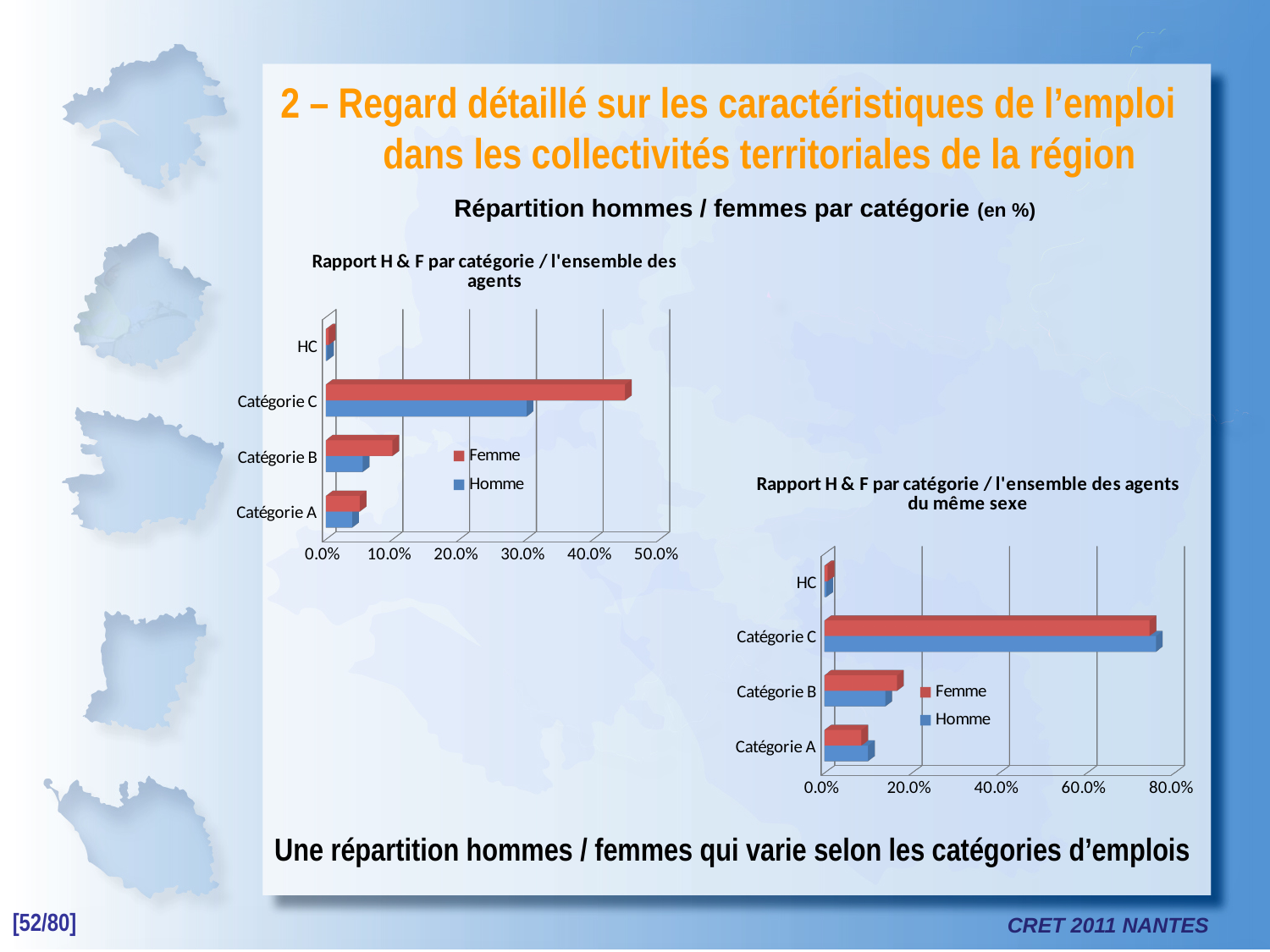
In the right chart, 'Rapport H & F par catégorie / l'ensemble des agents du même sexe', what colour represents the Femme series? Red In the right chart, 'Rapport H & F par catégorie / l'ensemble des agents du même sexe', how many series does the legend list? 2 In the right chart, 'Rapport H & F par catégorie / l'ensemble des agents du même sexe', which category has the highest Homme value? Catégorie C In the left chart, 'Rapport H & F par catégorie / l'ensemble des agents', is the Homme value for Catégorie C greater or less than 40.0%? less In the left chart, 'Rapport H & F par catégorie / l'ensemble des agents', is the Femme value for Catégorie C greater or less than 40.0%? greater In the left chart, 'Rapport H & F par catégorie / l'ensemble des agents', which category has the highest Femme value? Catégorie C In the left chart, 'Rapport H & F par catégorie / l'ensemble des agents', which is larger for Catégorie B, the Femme value or the Homme value? Femme In the right chart, 'Rapport H & F par catégorie / l'ensemble des agents du même sexe', is the Femme value for Catégorie C greater or less than 60.0%? greater In the left chart, 'Rapport H & F par catégorie / l'ensemble des agents', which category has the lowest Homme value? HC In the left chart, 'Rapport H & F par catégorie / l'ensemble des agents', what kind of chart is shown? Bar chart In the left chart, 'Rapport H & F par catégorie / l'ensemble des agents', how many categories are shown on the vertical axis? 4